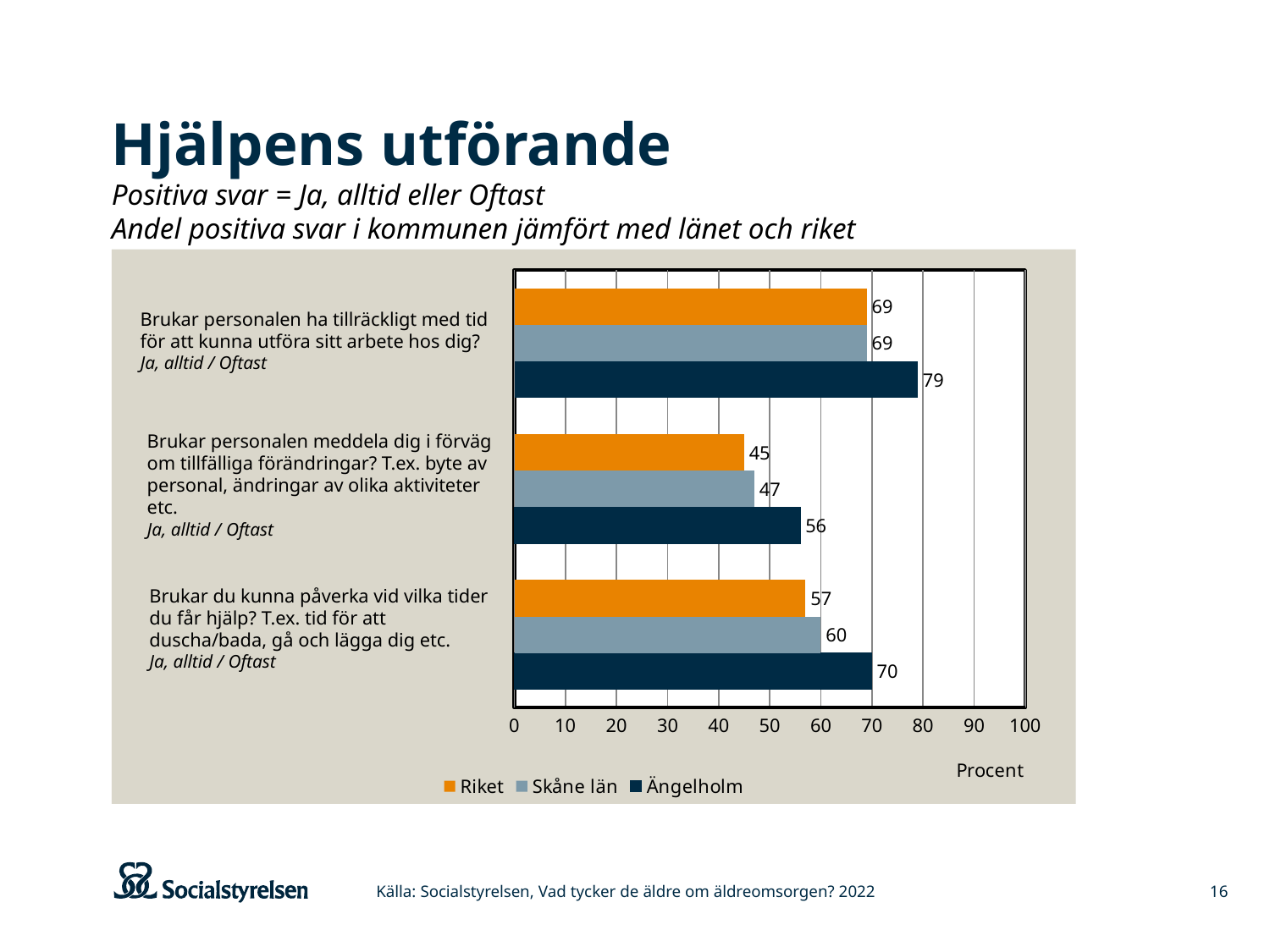
What is the value for Ängelholm on the question "Brukar personalen ha tillräckligt med tid för att kunna utföra sitt arbete hos dig?"? 79 Which series has the highest value on the question "Brukar personalen meddela dig i förväg om tillfälliga förändringar?"? Ängelholm What kind of chart is shown on the slide? Bar chart What is the difference between Ängelholm and Skåne län on the question "Brukar personalen ha tillräckligt med tid för att kunna utföra sitt arbete hos dig?"? 10 Which question has the lowest value for Riket? Brukar personalen meddela dig i förväg om tillfälliga förändringar? Is the value for Ängelholm on the question "Brukar personalen meddela dig i förväg om tillfälliga förändringar?" greater or less than 50? greater What is the value for Riket on the question "Brukar personalen meddela dig i förväg om tillfälliga förändringar?"? 45 How many questions (categories) are shown in the chart? 3 What is the difference between Ängelholm and Riket on the question "Brukar du kunna påverka vid vilka tider du får hjälp?"? 13 What is the value for Skåne län on the question "Brukar du kunna påverka vid vilka tider du får hjälp?"? 60 How many series does the legend list? 3 Which is larger on the question "Brukar personalen meddela dig i förväg om tillfälliga förändringar?": Skåne län or Ängelholm? Ängelholm